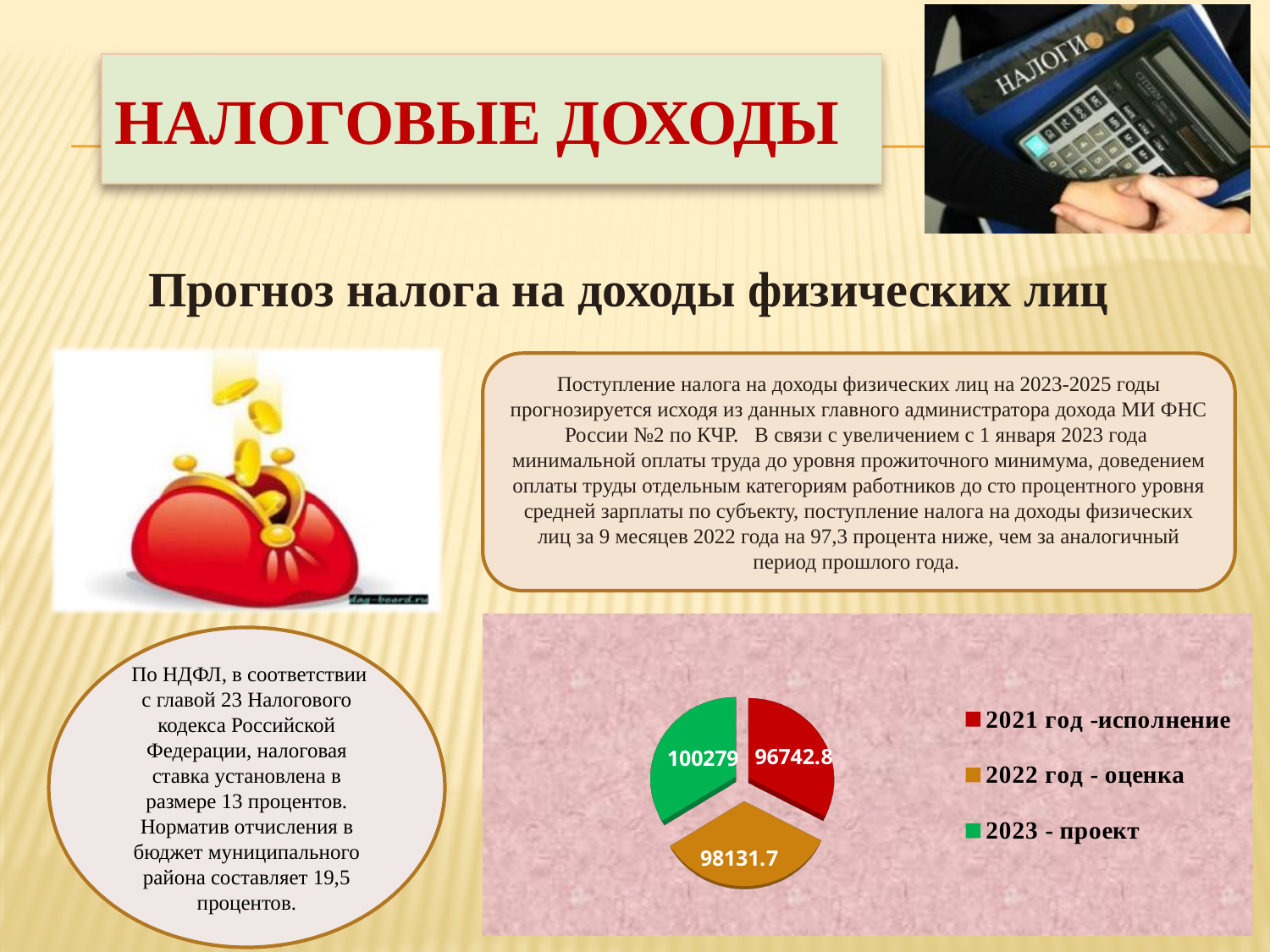
Which colour represents 2023 - проект in the pie chart? green Which is larger, the value for 2022 год - оценка or the value for 2023 - проект? 2023 - проект How many slices does the pie chart have? 3 What is the value for 2022 год - оценка in the pie chart? 98131.7 How many entries does the legend of the pie chart list? 3 Which category has the lowest value in the pie chart? 2021 год -исполнение What is the difference between the values for 2022 год - оценка and 2021 год -исполнение? 1388.9 What is the difference between the values for 2023 - проект and 2021 год -исполнение? 3536.2 What is the value for 2023 - проект in the pie chart? 100279 Which category has the highest value in the pie chart? 2023 - проект What type of chart is shown on the slide? pie chart What is the value for 2021 год -исполнение in the pie chart? 96742.8